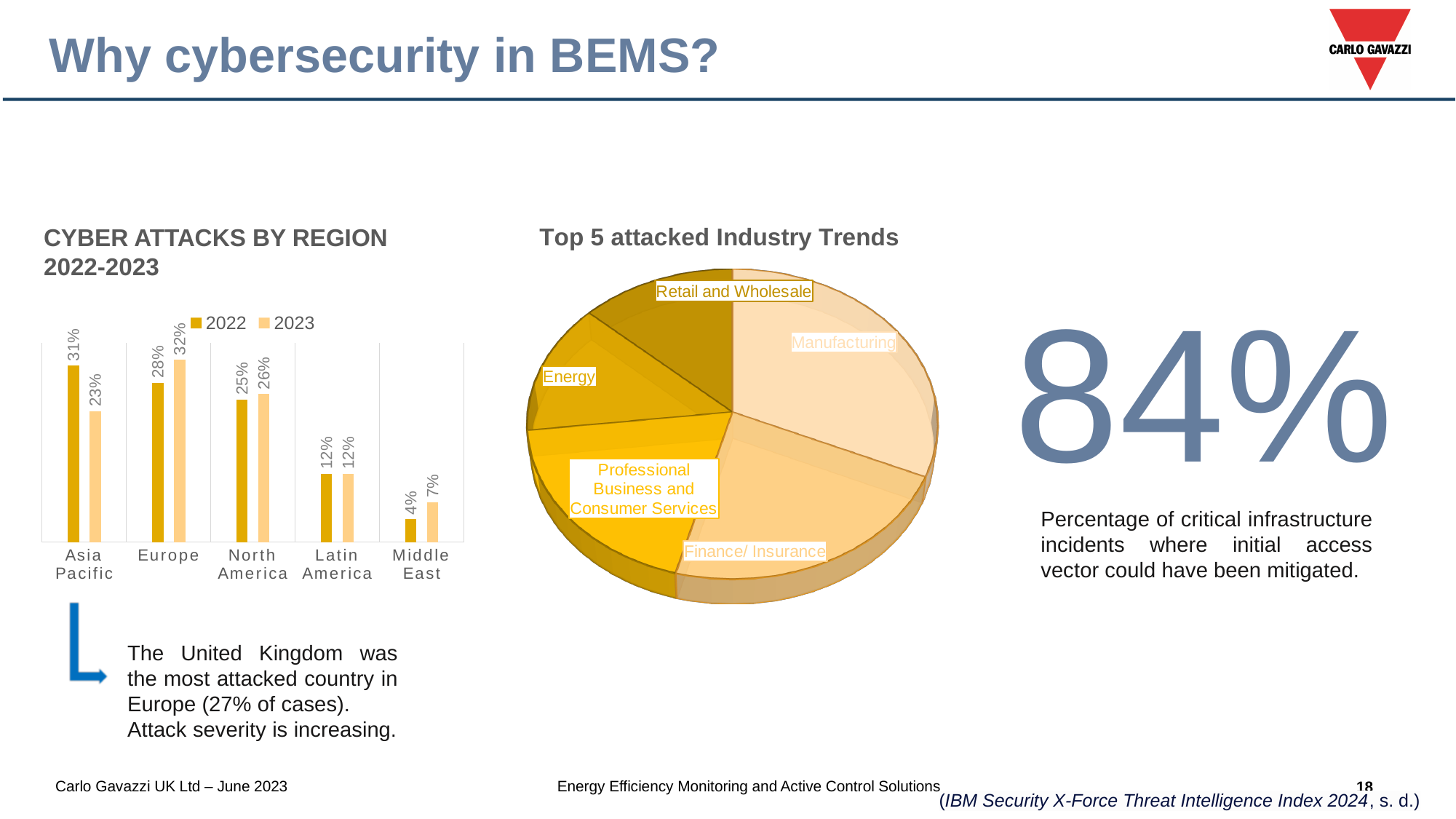
In the 'CYBER ATTACKS BY REGION 2022-2023' chart, how many regions are shown? 5 In the 'CYBER ATTACKS BY REGION 2022-2023' chart, what is the 2023 value for Middle East? 7% In the 'CYBER ATTACKS BY REGION 2022-2023' chart, what is the difference between the 2022 and 2023 values for Asia Pacific? 8% In the 'CYBER ATTACKS BY REGION 2022-2023' chart, what is the 2023 value for Europe? 32% In the 'CYBER ATTACKS BY REGION 2022-2023' chart, what is the 2022 value for Asia Pacific? 31% In the 'CYBER ATTACKS BY REGION 2022-2023' chart, how many series does the legend list? 2 What kind of chart is 'Top 5 attacked Industry Trends'? pie chart In the 'CYBER ATTACKS BY REGION 2022-2023' chart, which region has the lowest 2022 value? Middle East In the 'Top 5 attacked Industry Trends' chart, how many slices are there? 5 In the 'CYBER ATTACKS BY REGION 2022-2023' chart, which region has the highest 2023 value? Europe In the 'CYBER ATTACKS BY REGION 2022-2023' chart, is the 2022 value for Europe larger or smaller than the 2023 value for Europe? smaller What kind of chart is 'CYBER ATTACKS BY REGION 2022-2023'? bar chart